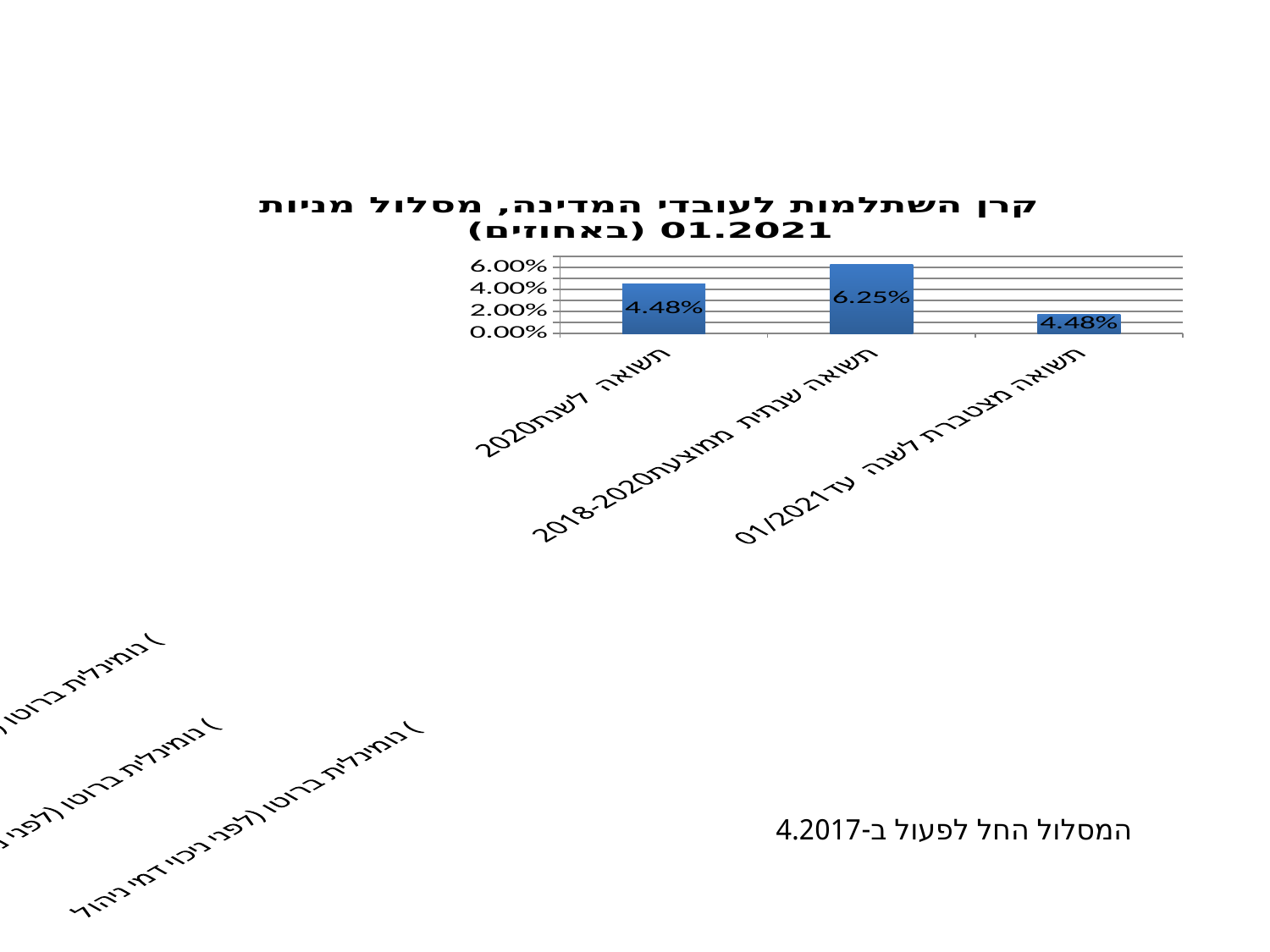
What is the value for תשואה לשנת 2020? 4.48% What is the value for תשואה שנתית ממוצעת 2018-2020? 6.25% Which category has the highest value? תשואה שנתית ממוצעת 2018-2020 What is the highest tick value shown on the y axis? 6.00% How many categories are shown on the x axis? 3 What value is labelled on the bar for תשואה מצטברת לשנה עד 01/2021? 4.48% What is the difference between the value for תשואה שנתית ממוצעת 2018-2020 and the value for תשואה לשנת 2020? 1.77% Is the value for תשואה לשנת 2020 greater or less than 6.00%? less What kind of chart is shown on the slide? bar chart What is the title of the chart? קרן השתלמות לעובדי המדינה, מסלול מניות 01.2021 (באחוזים) Is the value for תשואה שנתית ממוצעת 2018-2020 greater or less than 4.00%? greater Which is larger: the value for תשואה שנתית ממוצעת 2018-2020 or the value for תשואה לשנת 2020? תשואה שנתית ממוצעת 2018-2020